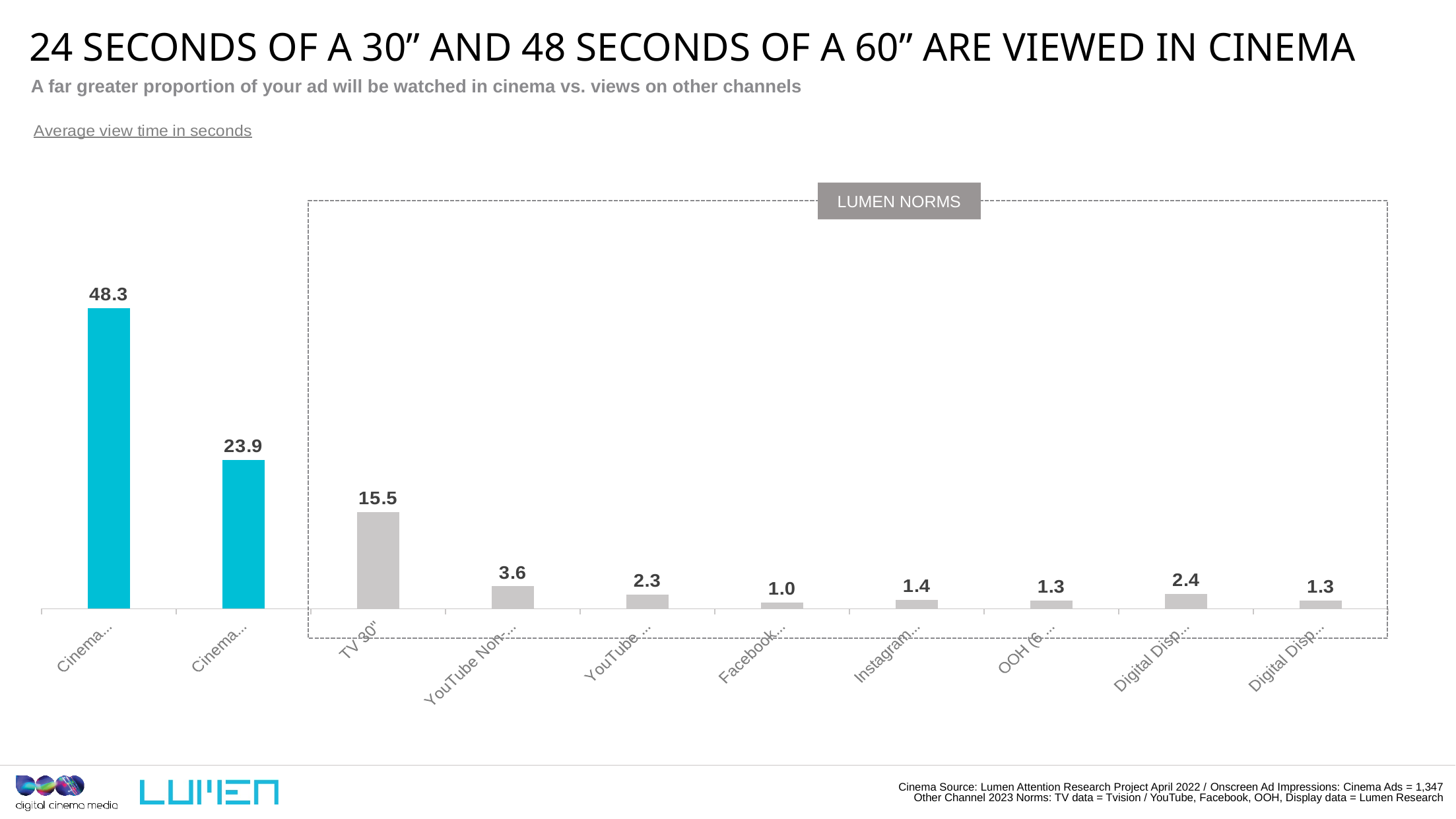
What is the average view time in seconds for TV 30"? 15.5 What type of chart is shown on the slide? Bar chart How many bars are plotted on the chart? 10 What is the value of the first (leftmost) Cinema bar? 48.3 Which bar has the lowest value on the chart? Facebook (1.0) What is the value shown for the Facebook bar? 1.0 What is the value shown for the Instagram bar? 1.4 What is the label of the box above the dashed outline enclosing the grey bars? LUMEN NORMS Which bar has the highest value on the chart? The first Cinema bar (48.3) Which is larger, the Instagram value or the Facebook value? Instagram What is the difference between the first Cinema bar and the TV 30" bar? 32.8 What is the value of the second Cinema bar? 23.9